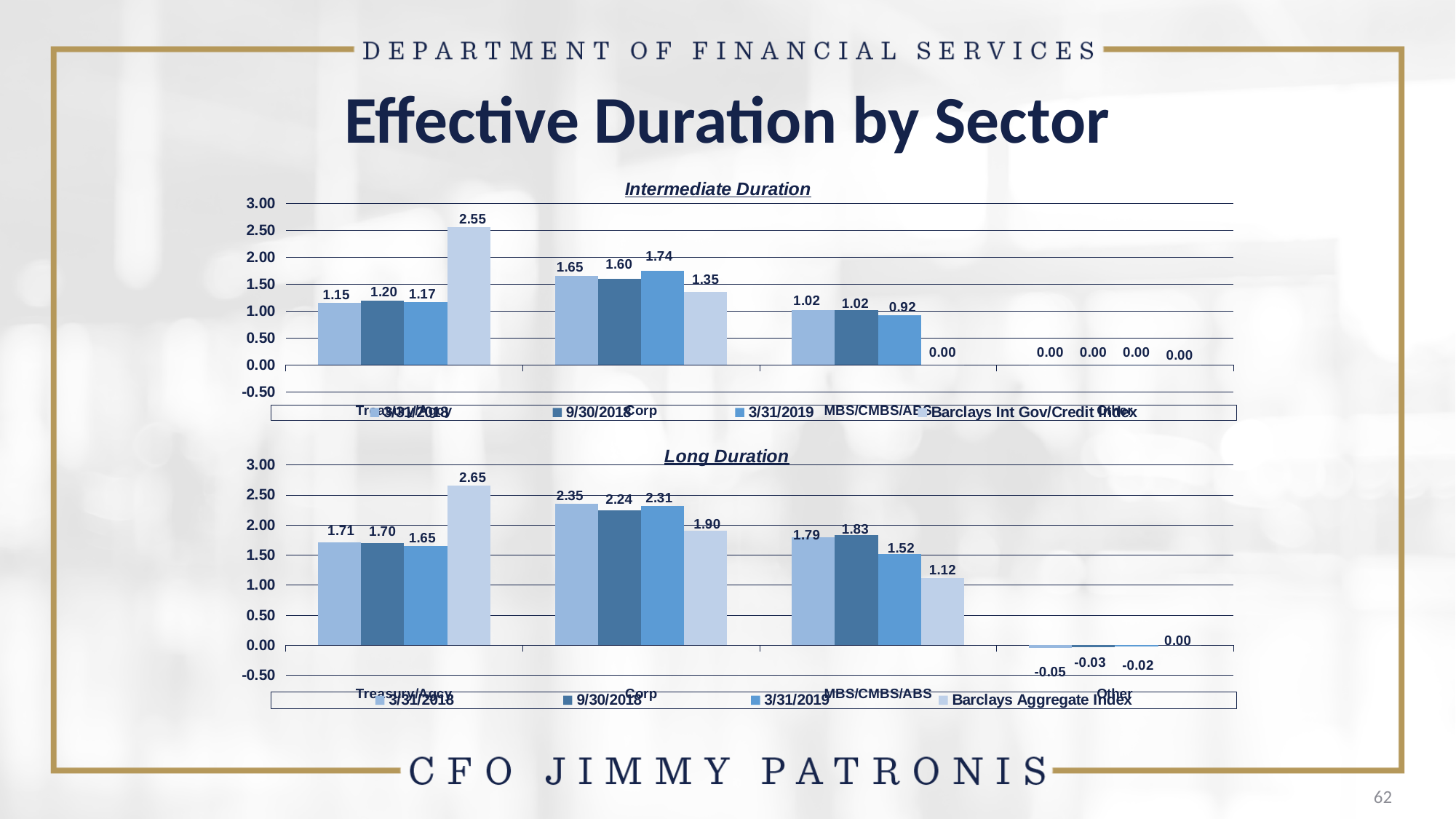
In the Intermediate Duration chart, which is larger for Corp: the 3/31/2018 value or the Barclays Int Gov/Credit Index value? 3/31/2018 In the Intermediate Duration chart, what is the value for Corp for the 3/31/2019 series? 1.74 In the Long Duration chart, which category has the highest Barclays Aggregate Index value? Treasury/Agcy In the Long Duration chart, what is the value for MBS/CMBS/ABS for the 9/30/2018 series? 1.83 In the Long Duration chart, what is the 3/31/2018 value for Other? -0.05 In the Intermediate Duration chart, which category has the lowest 3/31/2019 value among Treasury/Agcy, Corp and MBS/CMBS/ABS? MBS/CMBS/ABS In the Long Duration chart, do the 3/31/2019 values rise or fall from Corp to Other? Fall In the Intermediate Duration chart, what is the Barclays Int Gov/Credit Index value for Treasury/Agcy? 2.55 How many categories are shown on the x axis of the Long Duration chart? 4 How many series does the legend of the Long Duration chart list? 4 What type of chart is the Intermediate Duration chart? Bar chart In the Long Duration chart, what is the difference between the 3/31/2018 and 3/31/2019 values for Corp? 0.04